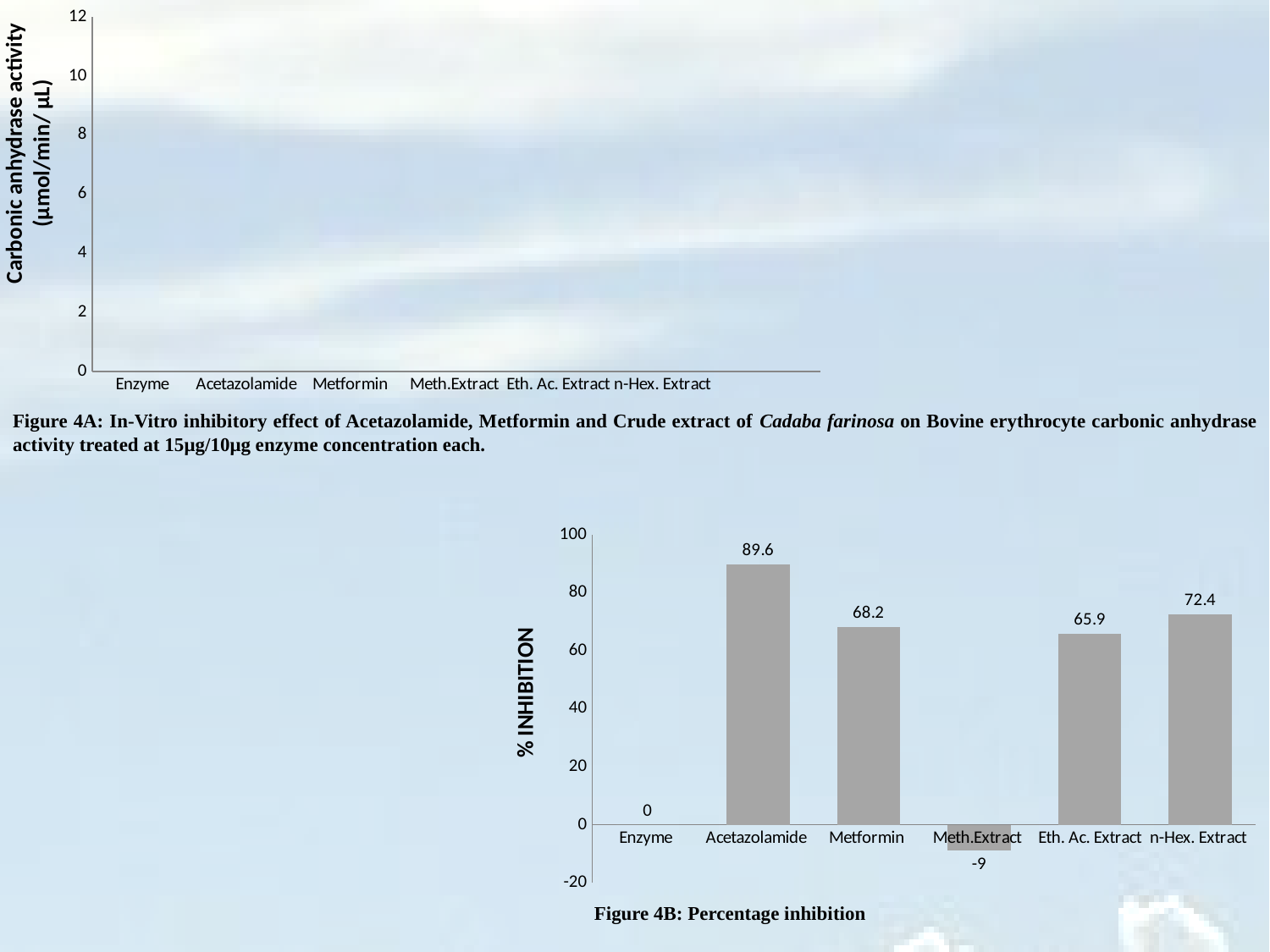
In Figure 4B: Percentage inhibition, is the value for Metformin greater or less than 60? greater In Figure 4B: Percentage inhibition, which has a higher % inhibition, n-Hex. Extract or Eth. Ac. Extract? n-Hex. Extract In Figure 4B: Percentage inhibition, what is the label on the vertical axis? % INHIBITION In Figure 4B: Percentage inhibition, which category has the highest % inhibition? Acetazolamide What kind of chart is Figure 4B: Percentage inhibition? bar chart In Figure 4B: Percentage inhibition, what is the % inhibition for Acetazolamide? 89.6 In Figure 4B: Percentage inhibition, how many categories are shown on the x axis? 6 In Figure 4B: Percentage inhibition, what is the % inhibition for Meth.Extract? -9 In Figure 4B: Percentage inhibition, what is the difference in % inhibition between n-Hex. Extract and Eth. Ac. Extract? 6.5 In Figure 4B: Percentage inhibition, which category has the lowest % inhibition? Meth.Extract In Figure 4B: Percentage inhibition, what is the % inhibition for Enzyme? 0 In Figure 4B: Percentage inhibition, what is the difference in % inhibition between Acetazolamide and Metformin? 21.4